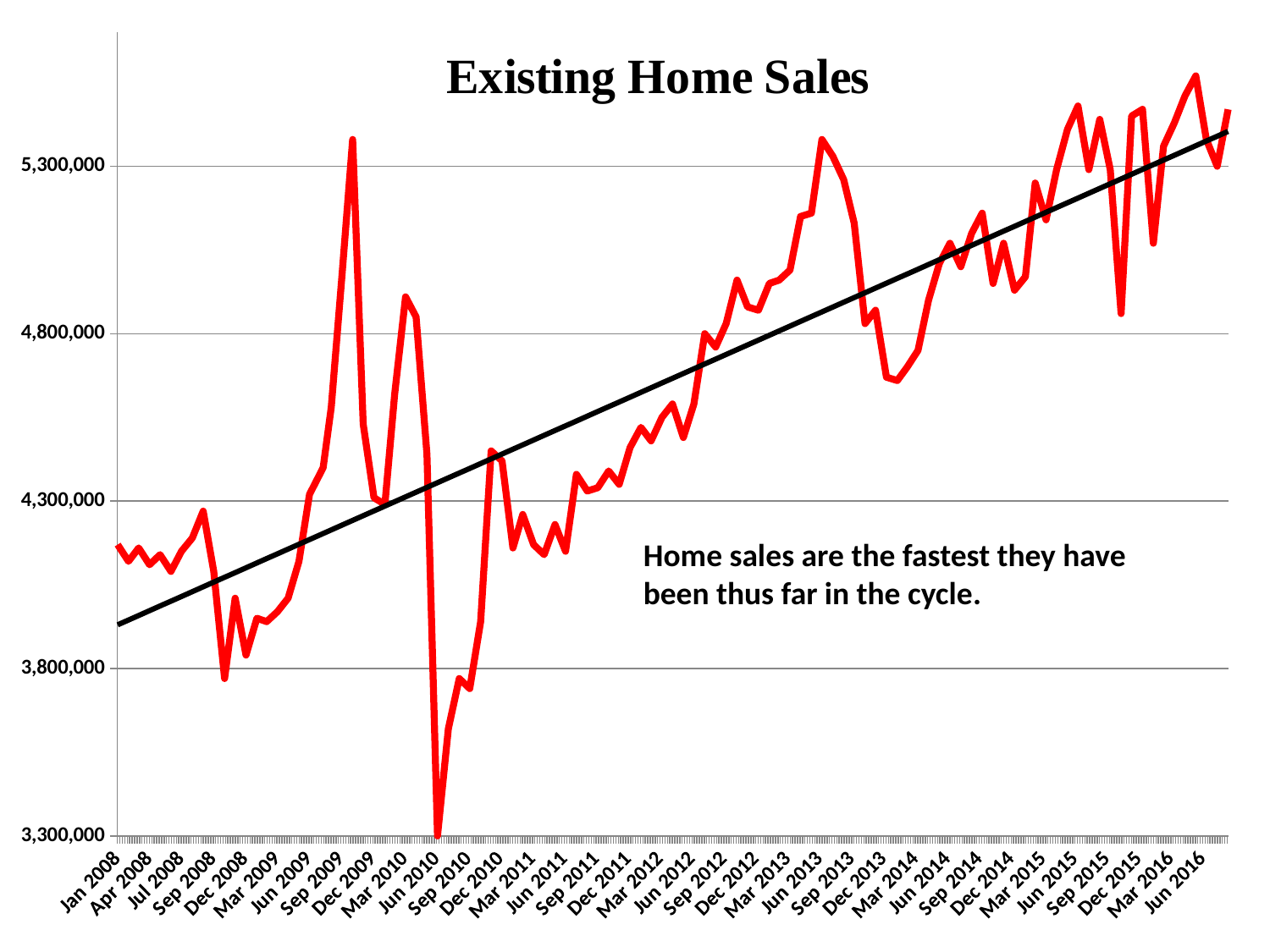
In which year does the red line reach its highest value? 2016 Is the value for Jan 2008 greater or less than 4,300,000? less What kind of chart is shown on the slide? line chart Is the lowest point of the red line, in mid-2010, greater or less than 3,800,000? less Is the value for Jun 2016 greater or less than 5,300,000? greater Does the black trend line rise or fall from Jan 2008 to Jun 2016? rise What colour is the straight trend line on the chart? black What is the title of the chart? Existing Home Sales In which year does the red line reach its lowest value? 2010